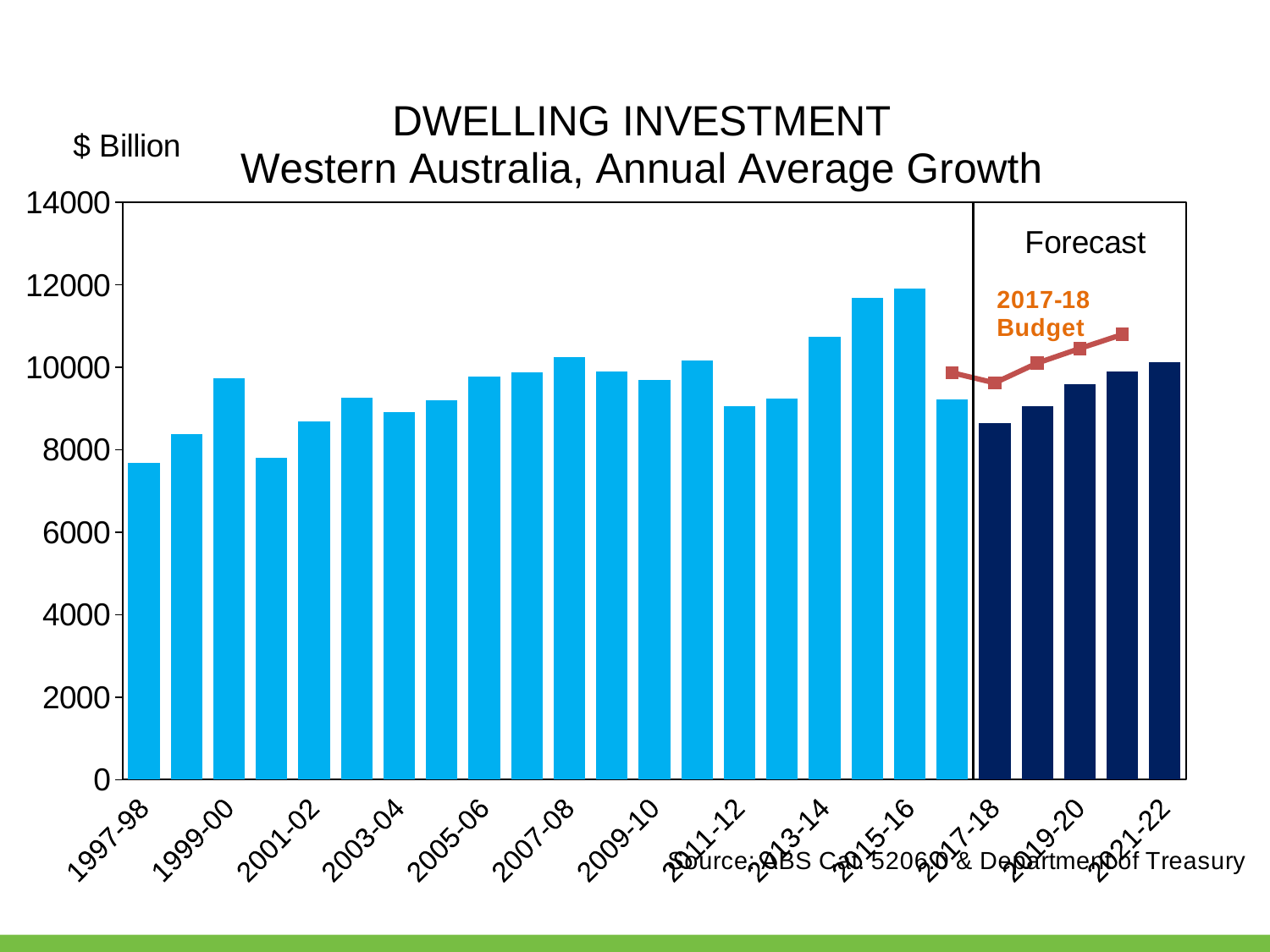
Is the value for 2013-14 greater or less than 10000? greater What label is given to the red line in the forecast section of the chart? 2017-18 Budget What is the title of the chart? DWELLING INVESTMENT Western Australia, Annual Average Growth Which is larger, the value for 2013-14 or the value for 2011-12? 2013-14 Do the forecast bars rise or fall from 2017-18 to 2021-22? rise Which is larger, the value for 2015-16 or the value for 1997-98? 2015-16 Is the value for 2001-02 greater or less than 10000? less How many bars are plotted on the chart? 25 What kind of chart is shown on the slide? Combination bar and line chart Is the value for 1997-98 greater or less than 8000? less